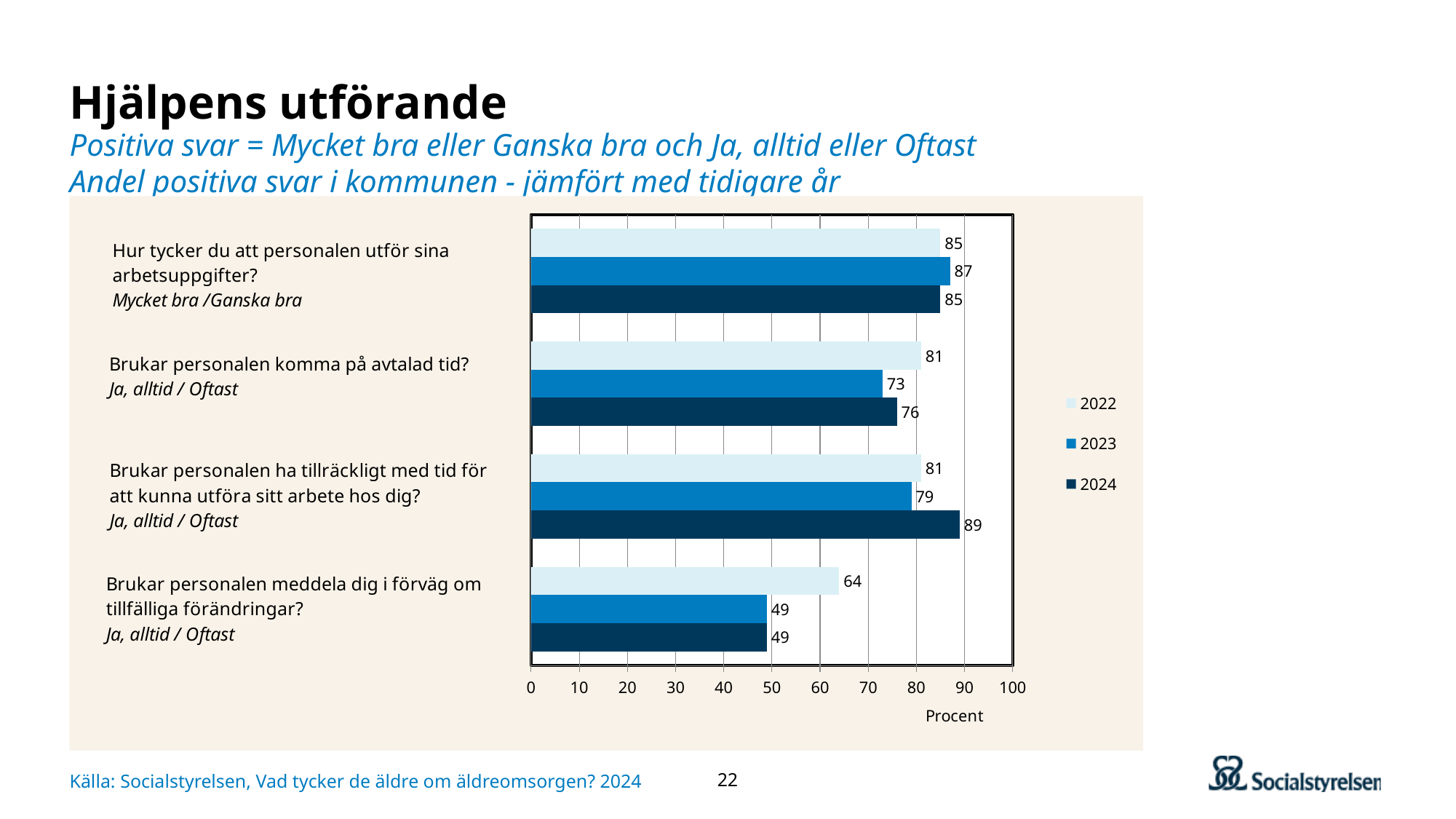
What kind of chart is shown on the slide? Bar chart What is the difference between the 2024 and 2023 values for "Brukar personalen ha tillräckligt med tid för att kunna utföra sitt arbete hos dig?"? 10 Is the 2023 value for "Brukar personalen meddela dig i förväg om tillfälliga förändringar?" greater or less than 50? less Which question has the highest 2024 value? Brukar personalen ha tillräckligt med tid för att kunna utföra sitt arbete hos dig? How many series does the legend list? 3 Which question has the lowest 2024 value? Brukar personalen meddela dig i förväg om tillfälliga förändringar? For "Brukar personalen komma på avtalad tid?", which year has the larger value, 2022 or 2023? 2022 What is the 2023 value for "Hur tycker du att personalen utför sina arbetsuppgifter?"? 87 What is the label of the x axis? Procent What is the 2022 value for "Brukar personalen meddela dig i förväg om tillfälliga förändringar?"? 64 What is the 2024 value for "Brukar personalen komma på avtalad tid?"? 76 How many questions (categories) are shown in the chart? 4